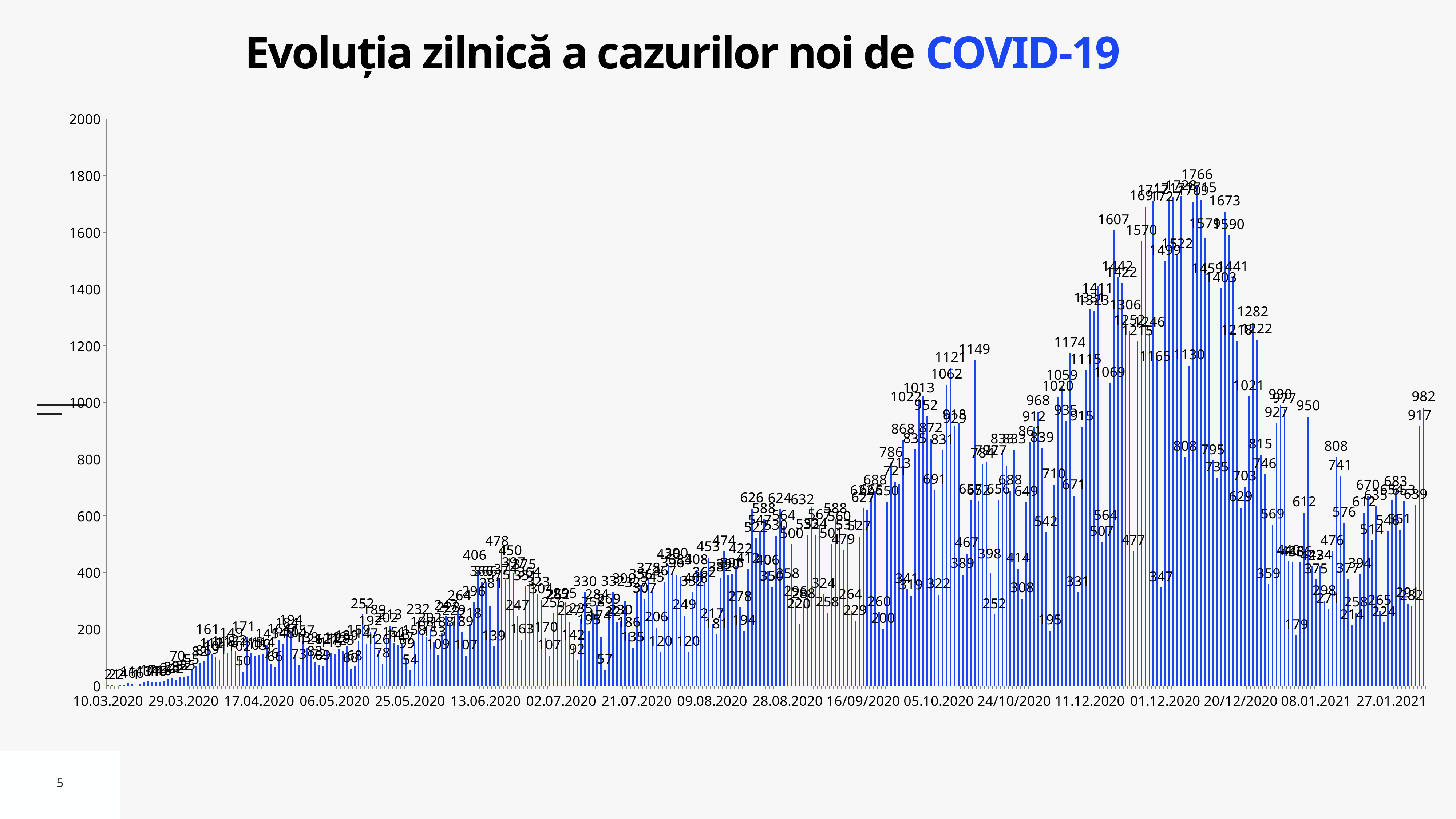
What is the title of the chart? Evoluția zilnică a cazurilor noi de COVID-19 What is the last date label on the horizontal axis? 27.01.2021 What is the highest daily value labelled on the chart? 1766 What is the maximum value shown on the vertical axis? 2000 What is the first date label on the horizontal axis? 10.03.2020 Which is larger, the bar labelled 1607 or the bar labelled 1766? 1766 Is the peak value around 13.06.2020 (478) greater or less than 600? less Is the highest bar on the chart greater or less than 1600? greater What kind of chart is shown on the slide? bar chart Do the daily values generally rise or fall from March 2020 to December 2020? rise What is the difference between the bars labelled 1766 and 1673? 93 Is the value for the first bar at 10.03.2020 greater or less than 200? less